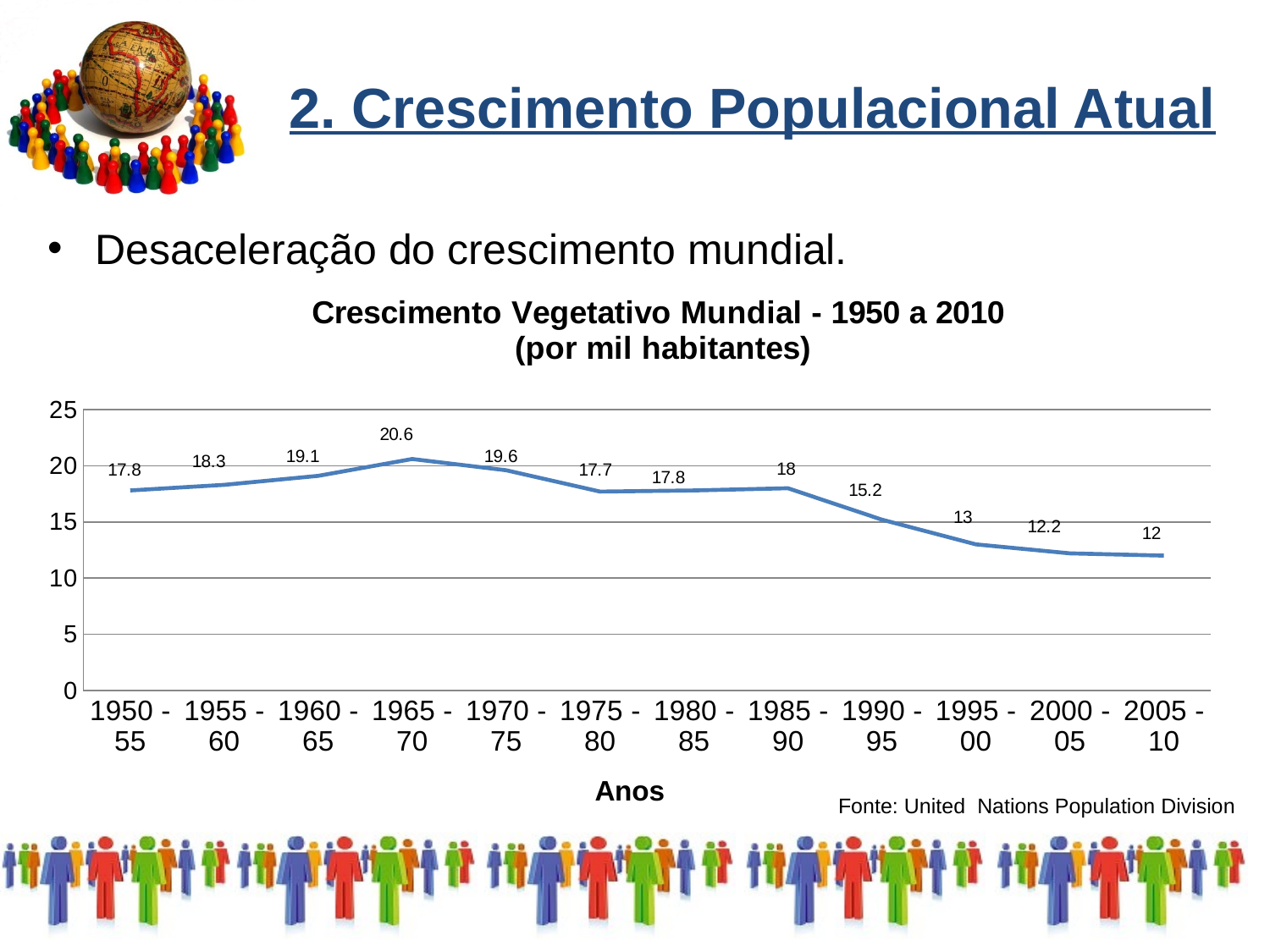
Which is larger, the value for 1985 - 90 or the value for 1995 - 00? 1985 - 90 How many periods are shown on the x axis? 12 Which period has the highest value? 1965 - 70 Is the value for 1960 - 65 greater or less than 15? greater What is the value for the period 2005 - 10? 12 Do the values rise or fall from 1965 - 70 to 2005 - 10? fall What is the value for the period 1990 - 95? 15.2 What is the title of the chart? Crescimento Vegetativo Mundial - 1950 a 2010 (por mil habitantes) What is the value for the period 1965 - 70? 20.6 What kind of chart is shown on the slide? line chart Which period has the lowest value? 2005 - 10 What is the difference between the values for 1965 - 70 and 2005 - 10? 8.6